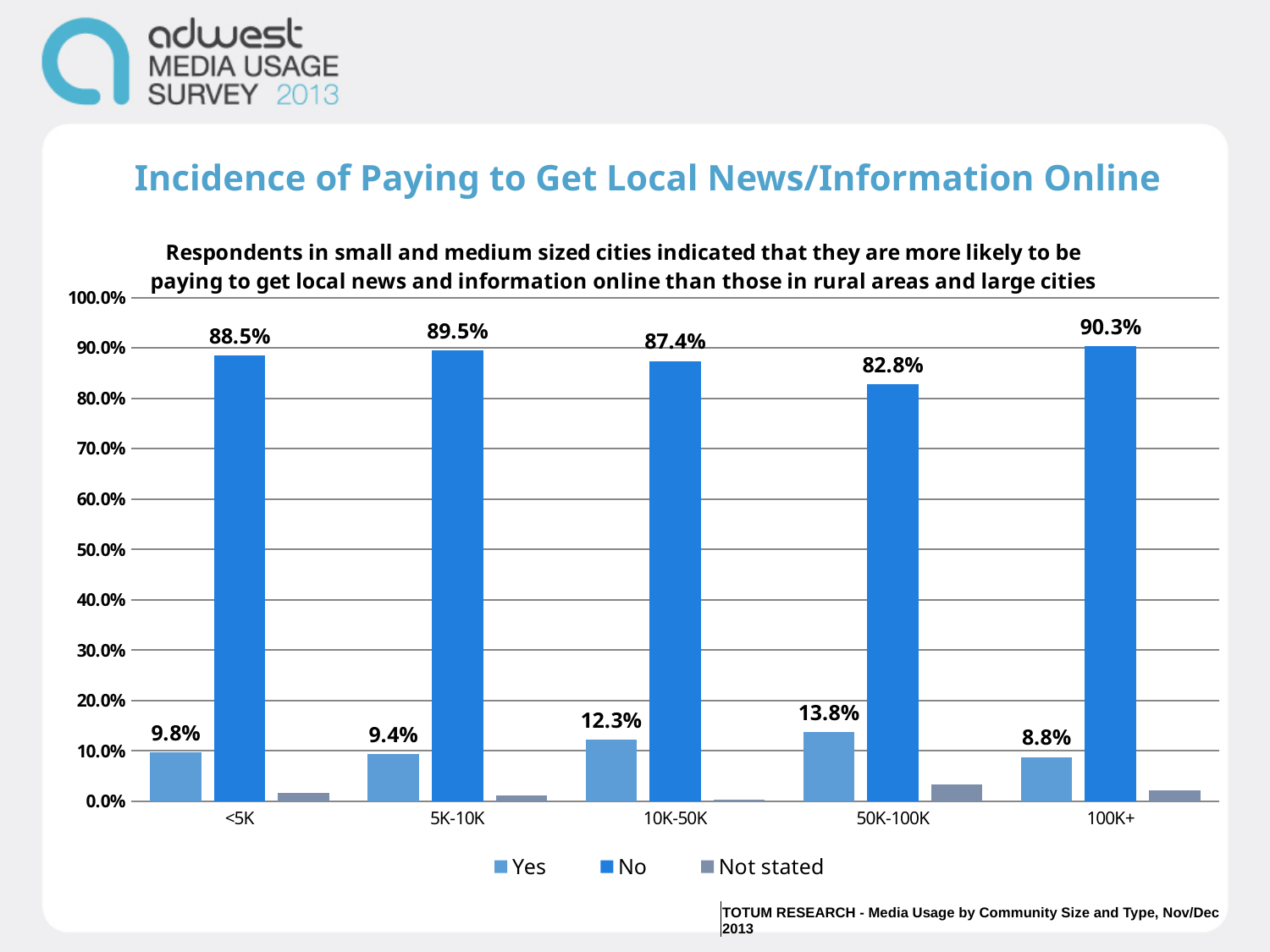
How many series does the legend list? 3 Which category has the lowest 'No' value? 50K-100K What is the 'No' value for the 100K+ category? 90.3% Is the 'Not stated' value for 50K-100K greater or less than 10.0%? less What is the 'Yes' value for the 50K-100K category? 13.8% What kind of chart is shown on the slide? bar chart What is the title of the chart? Respondents in small and medium sized cities indicated that they are more likely to be paying to get local news and information online than those in rural areas and large cities Which category has the highest 'Yes' value? 50K-100K What is the 'Yes' value for the <5K category? 9.8% What is the difference between the 'No' values for 100K+ and 50K-100K? 7.5% How many community size categories are shown on the x axis? 5 Which is larger, the 'Yes' value for 10K-50K or the 'Yes' value for 5K-10K? 10K-50K